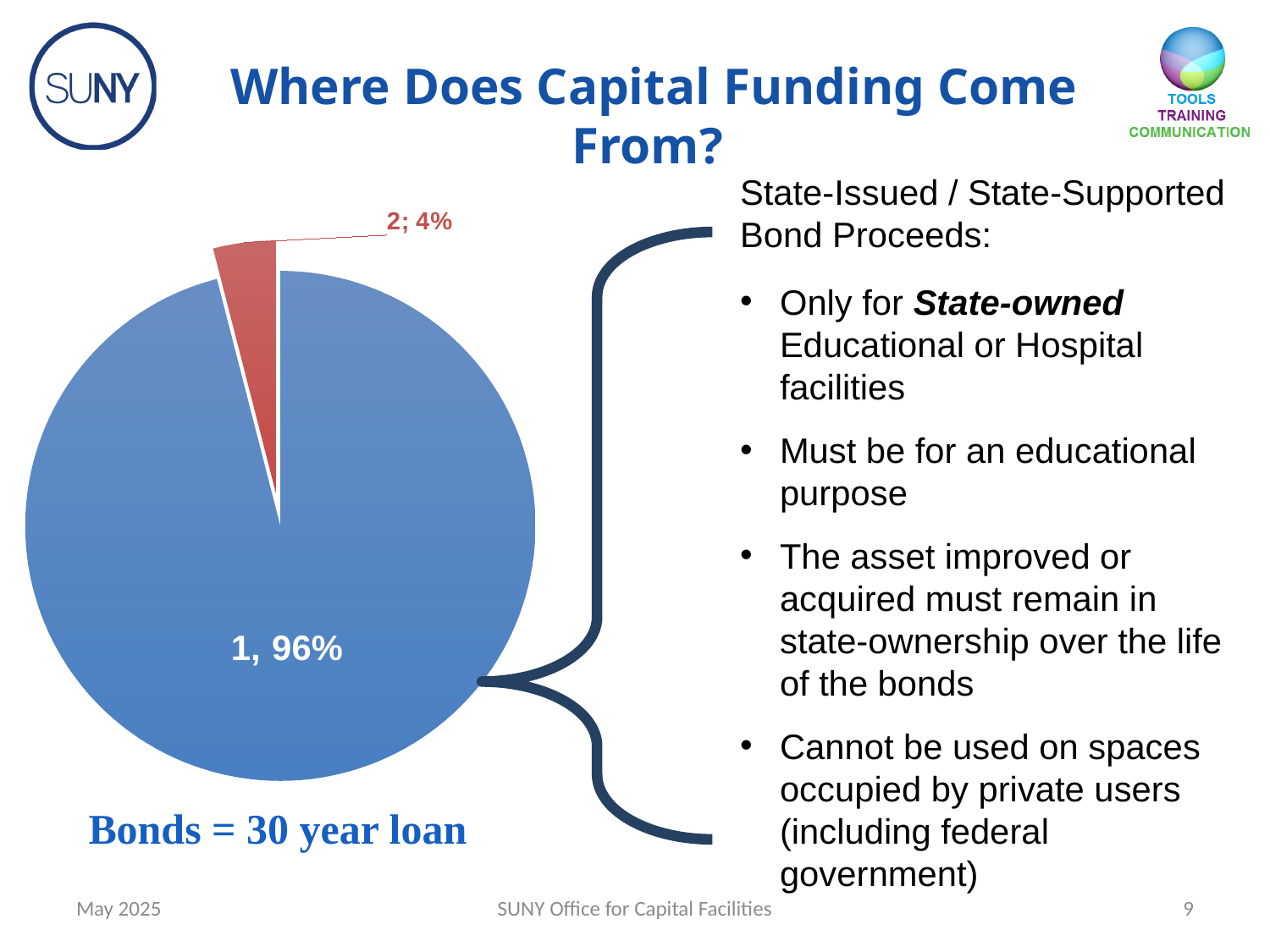
What is the data label shown on the small red slice? 2; 4% How many slices does the pie chart have? 2 What share of the pie does slice 1 represent? 96% What share of the pie does slice 2 represent? 4% What is the difference in percentage points between slice 1 and slice 2? 92 percentage points Which slice of the pie chart is the smallest? 2 What is the title of the slide containing the pie chart? Where Does Capital Funding Come From? Which slice of the pie chart is the largest? 1 What colour is the largest slice of the pie chart? blue Which is larger, slice 1 or slice 2? slice 1 What kind of chart is shown on the slide? pie chart What is the data label shown on the large blue slice? 1, 96%